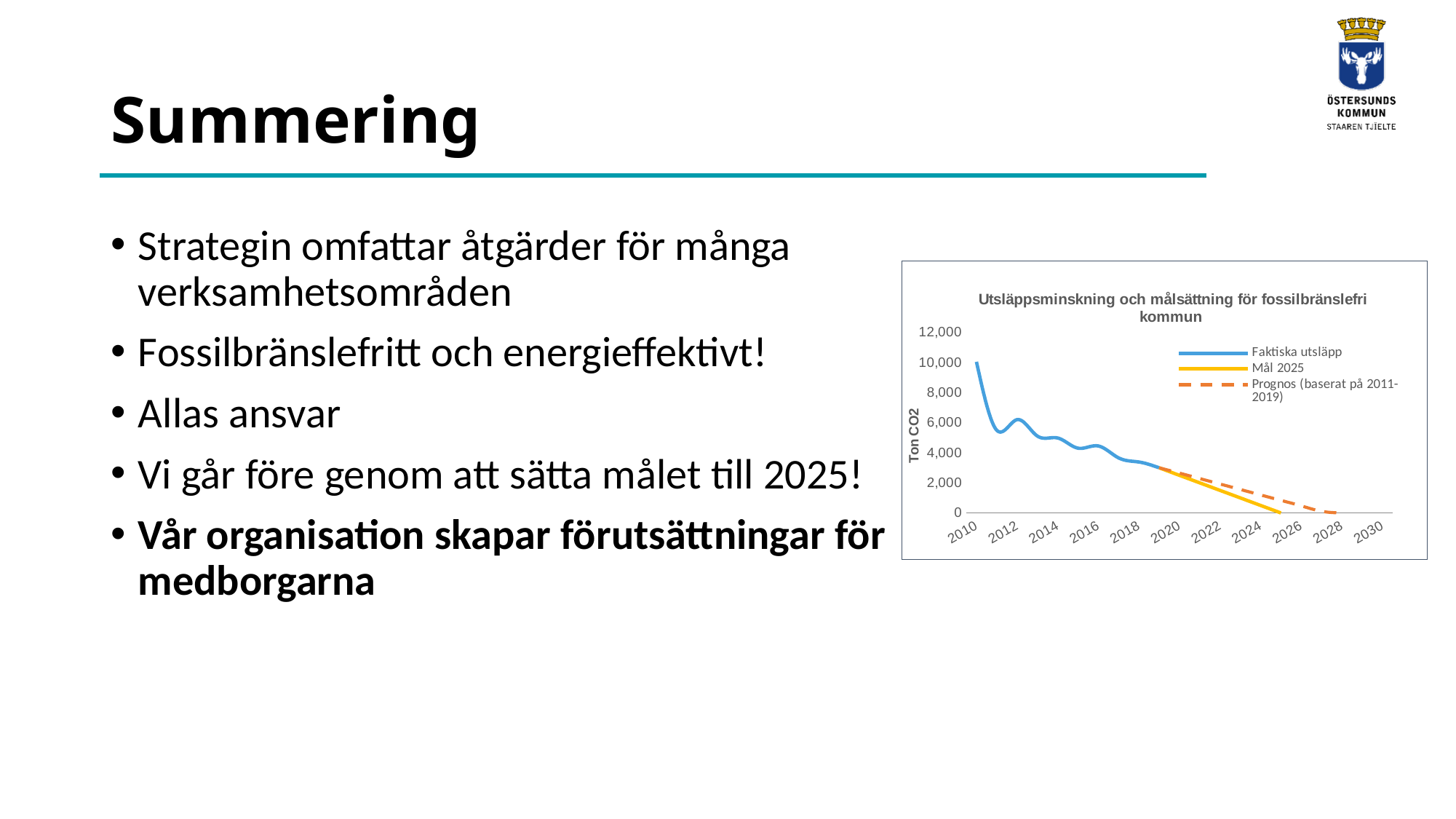
Which series in the chart is drawn with a dashed line? Prognos (baserat på 2011-2019) Which series reaches zero later on the x axis, Mål 2025 or Prognos (baserat på 2011-2019)? Prognos (baserat på 2011-2019) Which year has the highest value for Faktiska utsläpp? 2010 Is the value for Faktiska utsläpp in 2018 greater or less than 4,000? less Which is larger, the Faktiska utsläpp value in 2010 or in 2018? 2010 What kind of chart is shown on the slide? line chart Is the value for Faktiska utsläpp in 2010 greater or less than 8,000? greater What is the title of the chart? Utsläppsminskning och målsättning för fossilbränslefri kommun How many series does the chart's legend list? 3 Do the actual emissions (Faktiska utsläpp) rise or fall from 2010 to 2019? fall Is the value for Faktiska utsläpp in 2012 greater or less than 4,000? greater